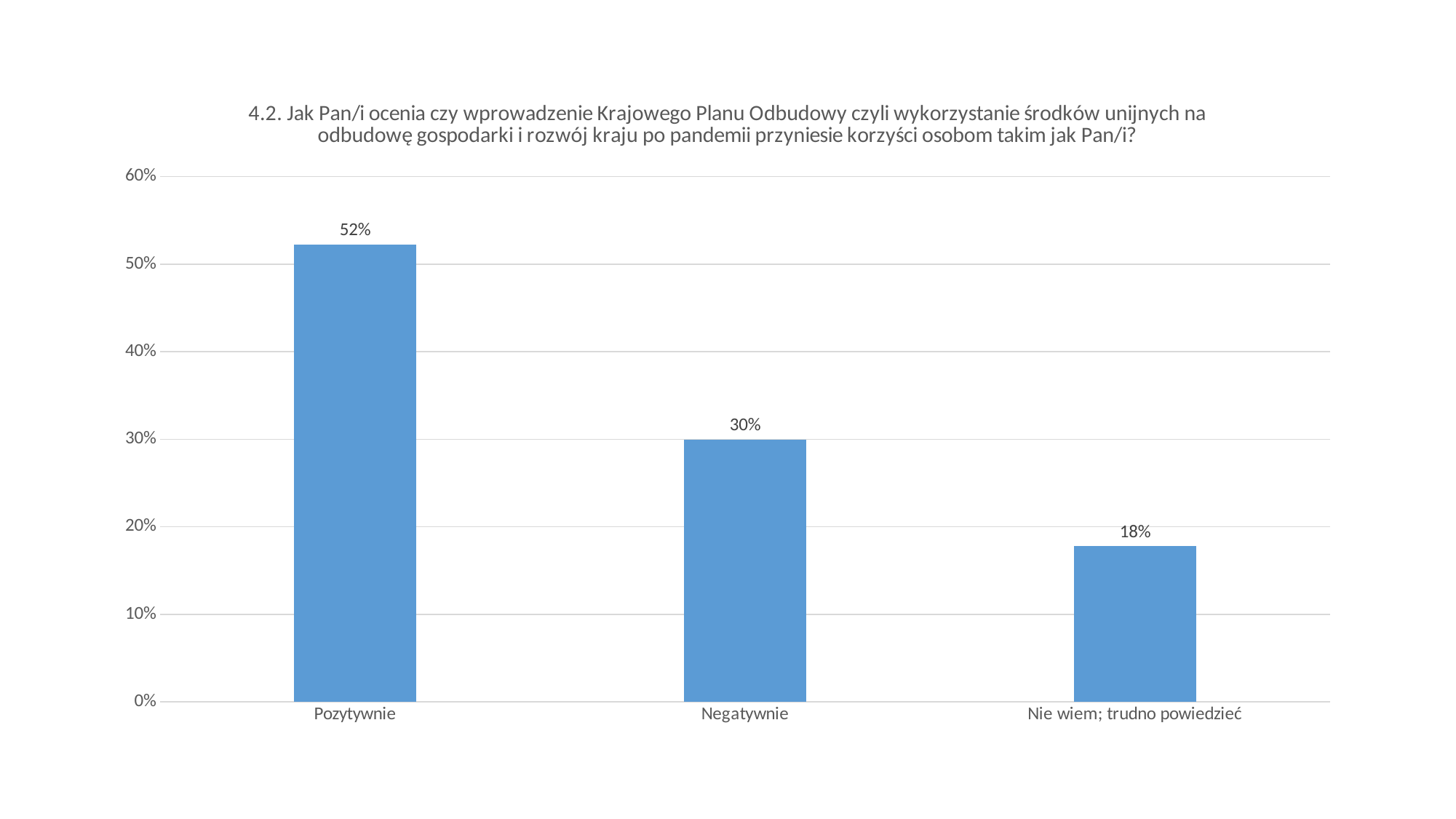
What is the difference between the values for Pozytywnie and Negatywnie? 22% Do the values rise or fall from left to right along the x axis? fall Which is larger, the value for Negatywnie or the value for Nie wiem; trudno powiedzieć? Negatywnie Is the value for Pozytywnie greater or less than 50%? greater What kind of chart is shown on the slide? bar chart What is the value for Pozytywnie? 52% What is the value for Negatywnie? 30% Which category has the highest value? Pozytywnie How many categories are shown on the x axis? 3 Which category has the lowest value? Nie wiem; trudno powiedzieć What is the value for Nie wiem; trudno powiedzieć? 18% What is the difference between the values for Negatywnie and Nie wiem; trudno powiedzieć? 12%